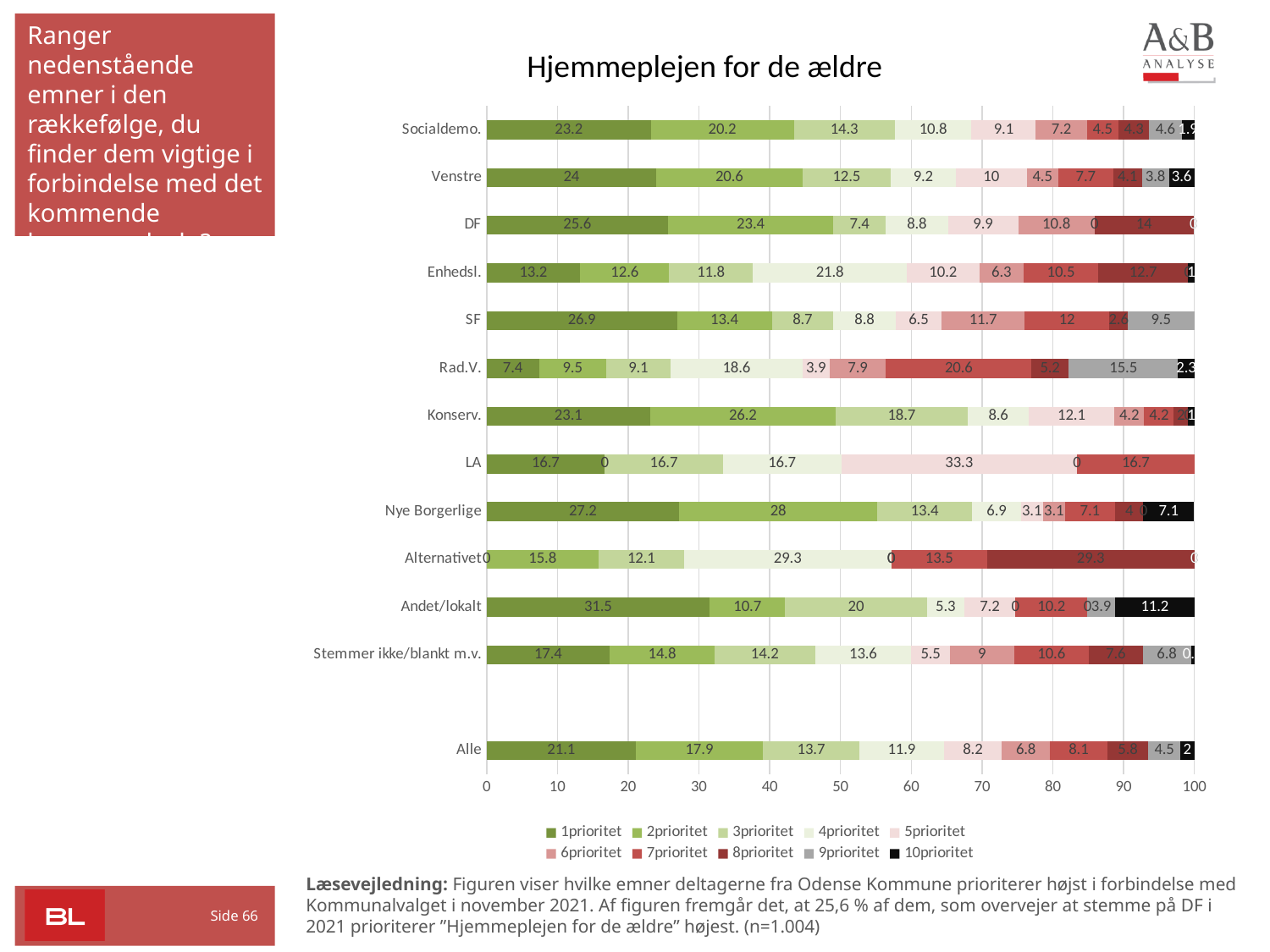
What is the 7prioritet value for Rad.V.? 20.6 How many categories (rows) are plotted on the chart? 13 What is the 2prioritet value for Nye Borgerlige? 28 What is the difference between the 1prioritet and 2prioritet values for Alle? 3.2 Which category has the highest 1prioritet value? Andet/lokalt Which is larger, the 4prioritet value for LA or the 4prioritet value for Alle? LA What is the 1prioritet value for Alle? 21.1 How many series does the legend list? 10 Which category has the lowest 1prioritet value? Alternativet What is the 1prioritet value for DF? 25.6 What kind of chart is shown on the slide? Stacked bar chart What is the title of the chart? Hjemmeplejen for de ældre